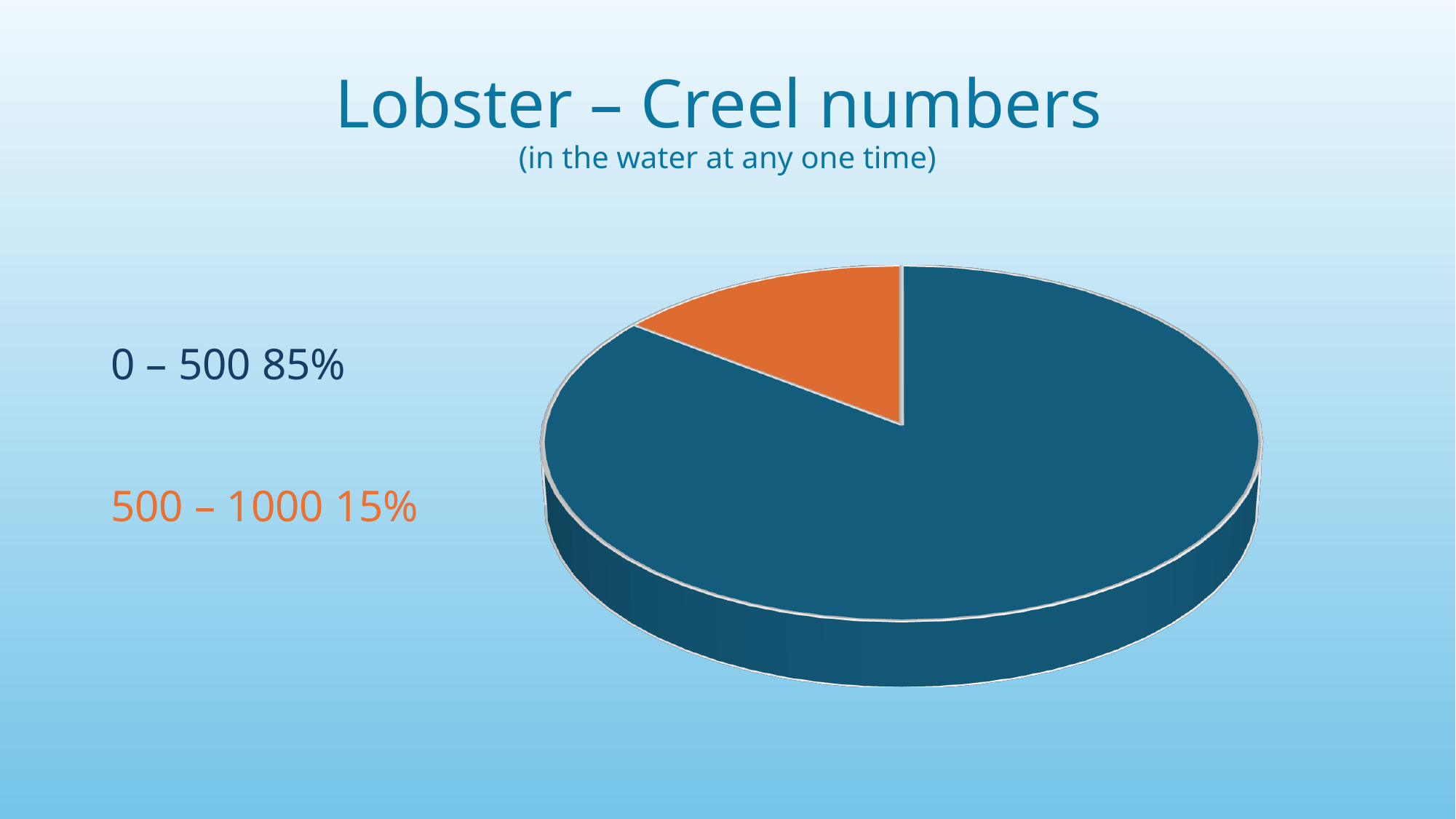
What share of the pie does the 500 – 1000 category have? 15% Which category has the largest slice of the pie? 0 – 500 What colour is the 500 – 1000 slice of the pie? orange What is the total of the two percentages shown for the pie slices? 100% Which category has the smallest slice of the pie? 500 – 1000 How many slices does the pie chart have? 2 What is the difference in percentage points between the 0 – 500 slice and the 500 – 1000 slice? 70 Which is larger, the 0 – 500 slice or the 500 – 1000 slice? 0 – 500 What share of the pie does the 0 – 500 category have? 85% What kind of chart is shown on the slide? pie chart What is the title of the chart on the slide? Lobster – Creel numbers